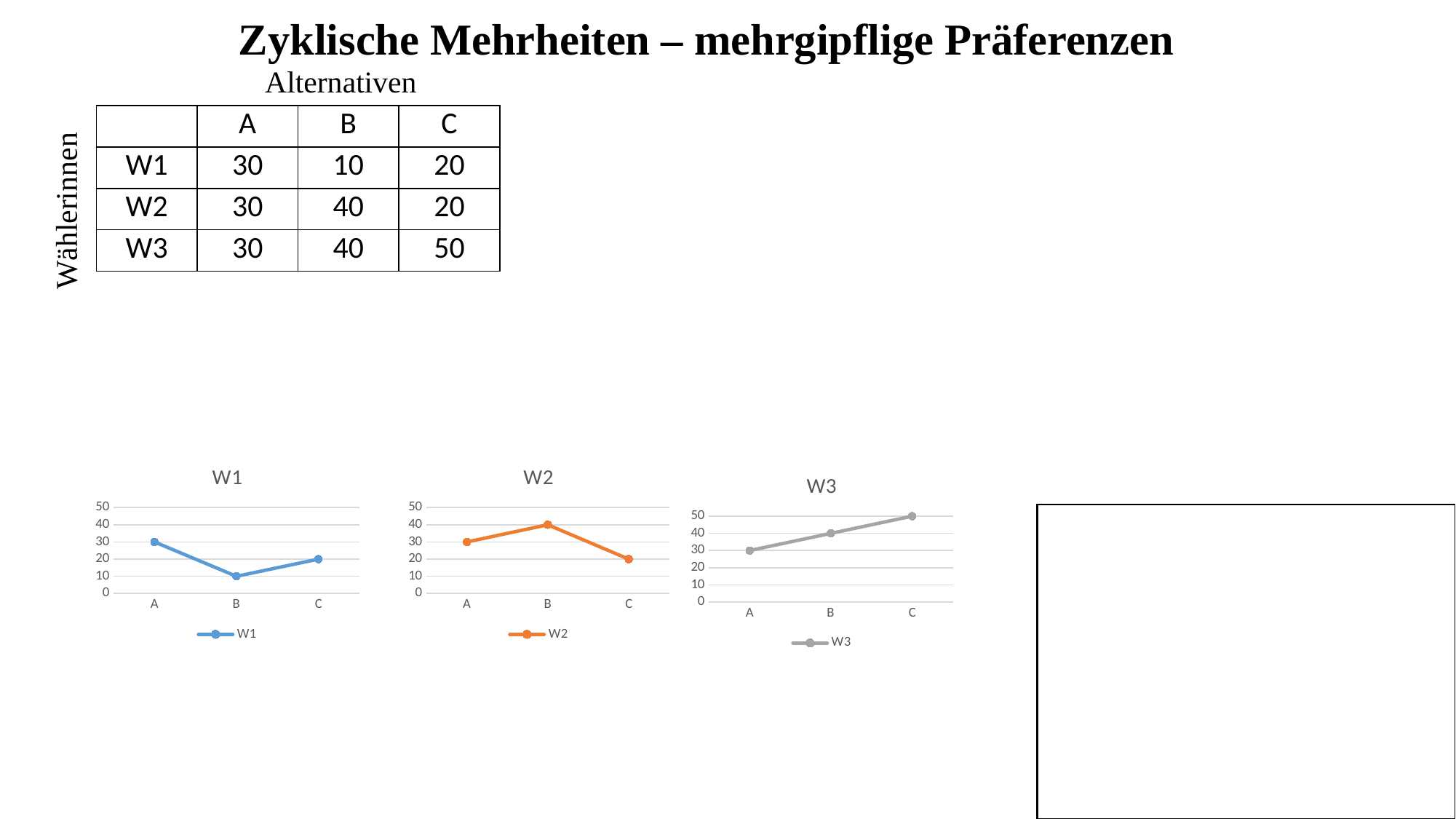
In the W1 chart, which category has the highest value? A In the W3 chart, what is the value for C? 50 In the W3 chart, what is the difference between the values for C and A? 20 How many categories are shown on the x axis of the W1 chart? 3 In the W2 chart, what is the value for B? 40 In the W3 chart, do the values rise or fall from A to C? rise How many series does the legend of the W3 chart list? 1 What kind of chart is the W2 chart? line chart In the W1 chart, what is the value for B? 10 In the W3 chart, which category has the lowest value? A In the W2 chart, which is larger, the value for A or the value for C? A In the W2 chart, which category has the lowest value? C